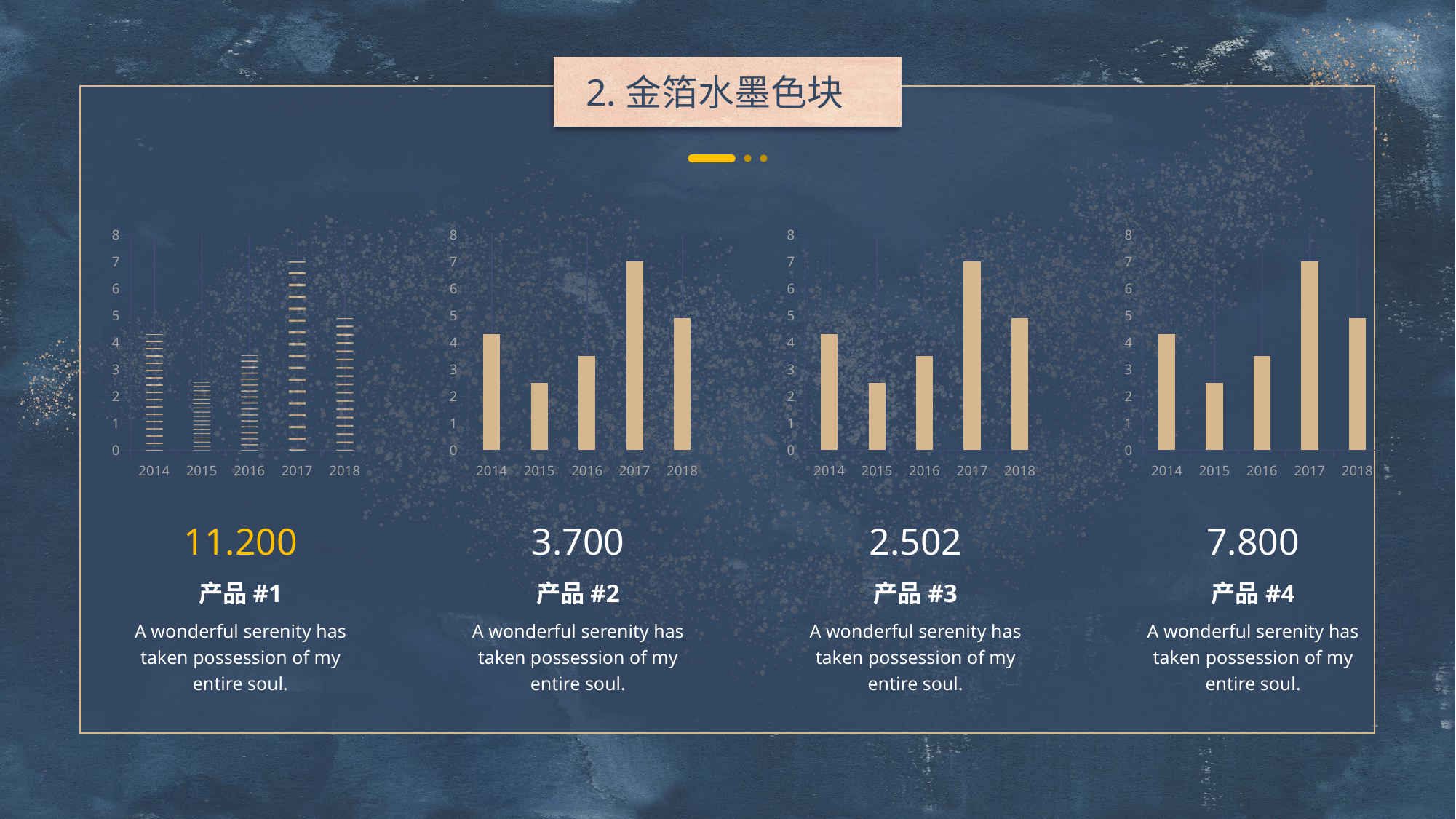
What is the highest value shown on the y axis of the leftmost chart (above 产品 #1)? 8 In the chart above 产品 #3, is the value for 2015 greater or less than 3? less In the chart above 产品 #2, which is larger, the value for 2014 or the value for 2016? 2014 In the chart above 产品 #2, is the value for 2014 greater or less than 4? greater How many years are shown on the x axis of the chart above 产品 #2? 5 What kind of chart is shown above 产品 #3? bar chart In the chart above 产品 #4, is the value for 2016 greater or less than 4? less How many bar charts are shown on the slide? 4 In the leftmost chart (above 产品 #1), which year has the lowest bar? 2015 In the chart above 产品 #4, which is larger, the value for 2017 or the value for 2018? 2017 In the leftmost chart (above 产品 #1), which year has the highest bar? 2017